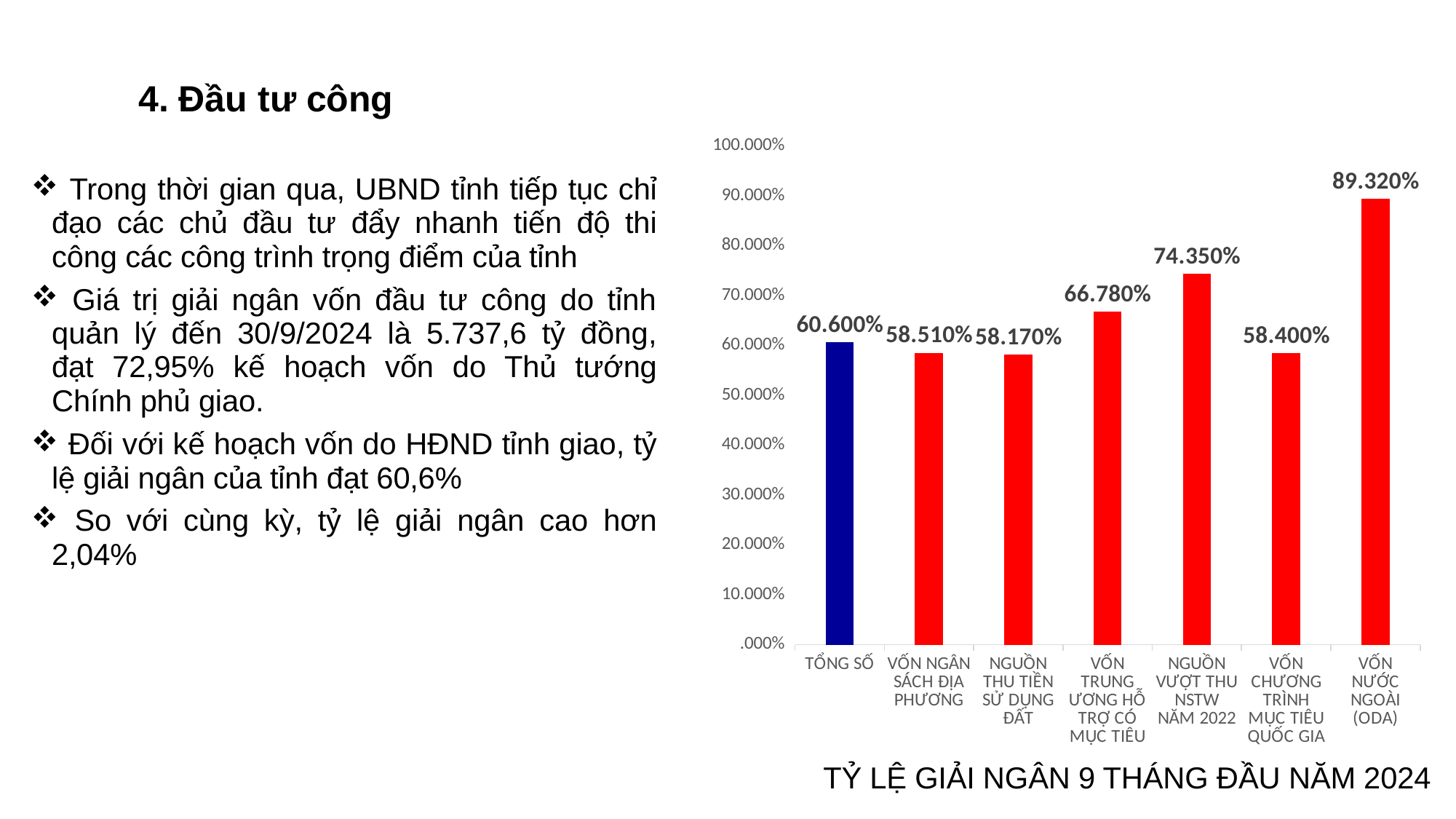
Which category has the highest value? VỐN NƯỚC NGOÀI (ODA) What is the value for TỔNG SỐ? 60.600% What is the value for VỐN TRUNG ƯƠNG HỖ TRỢ CÓ MỤC TIÊU? 66.780% Which category has the lowest value? NGUỒN THU TIỀN SỬ DỤNG ĐẤT What is the difference between the values for TỔNG SỐ and VỐN NGÂN SÁCH ĐỊA PHƯƠNG? 2.090% What kind of chart is shown on the slide? Bar chart Which is larger, the value for VỐN TRUNG ƯƠNG HỖ TRỢ CÓ MỤC TIÊU or the value for VỐN CHƯƠNG TRÌNH MỤC TIÊU QUỐC GIA? VỐN TRUNG ƯƠNG HỖ TRỢ CÓ MỤC TIÊU How many categories are shown on the chart? 7 What is the value for NGUỒN VƯỢT THU NSTW NĂM 2022? 74.350% What is the title of the chart? TỶ LỆ GIẢI NGÂN 9 THÁNG ĐẦU NĂM 2024 What is the difference between the values for VỐN NƯỚC NGOÀI (ODA) and NGUỒN VƯỢT THU NSTW NĂM 2022? 14.970% What is the value for VỐN NƯỚC NGOÀI (ODA)? 89.320%